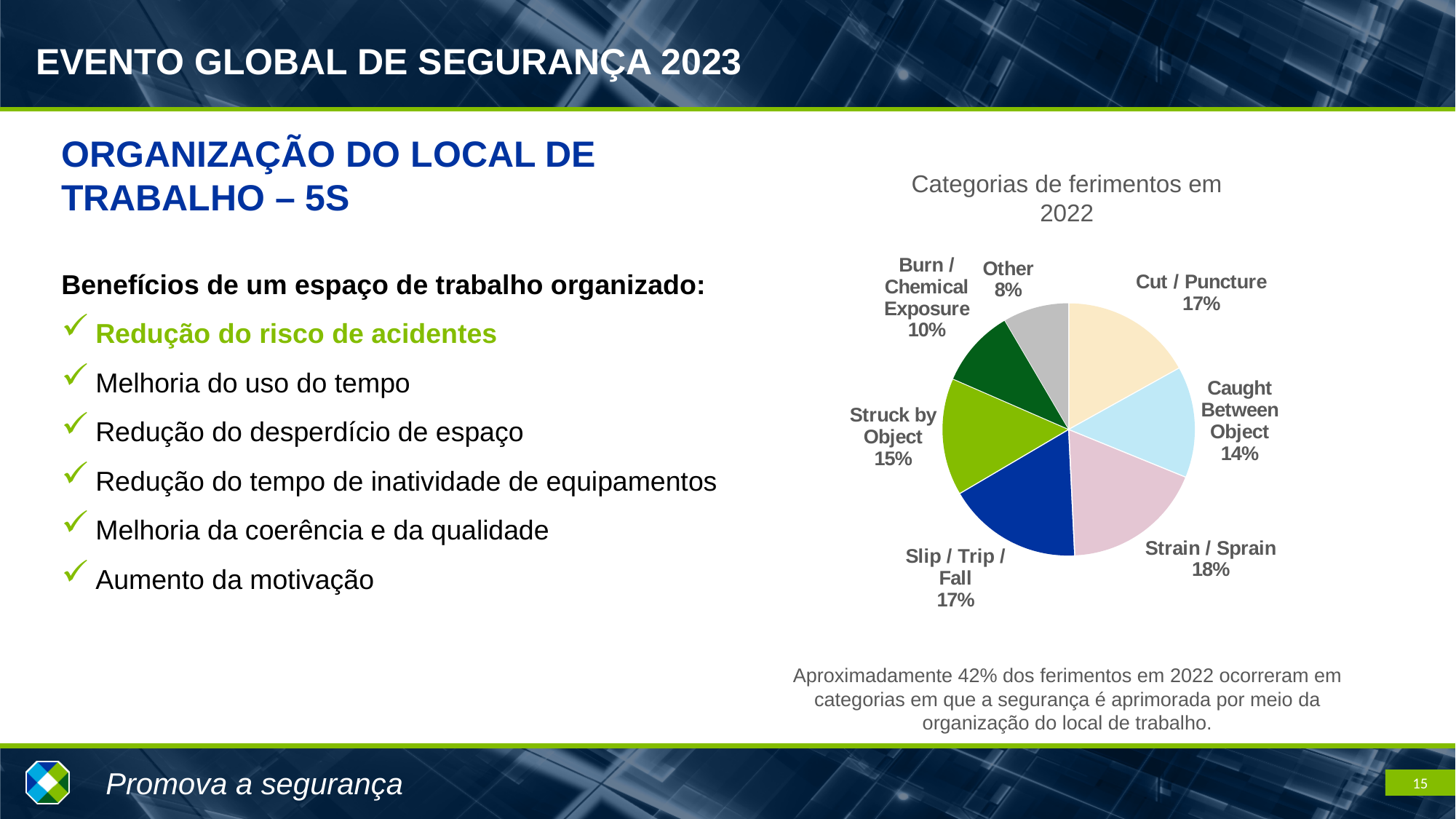
How many categories are shown in the pie chart? 7 What share of the pie is Struck by Object? 15% What is the combined share of Slip / Trip / Fall and Cut / Puncture? 34% What percentage of injuries in 2022 were Strain / Sprain? 18% Which is larger, Struck by Object or Caught Between Object? Struck by Object What colour is the Slip / Trip / Fall slice? dark blue What type of chart is shown on the slide? pie chart What is the difference between the Strain / Sprain share and the Caught Between Object share? 4% Which injury category has the smallest share? Other Which injury category has the largest share? Strain / Sprain What is the value for Burn / Chemical Exposure? 10% What is the title of the chart? Categorias de ferimentos em 2022